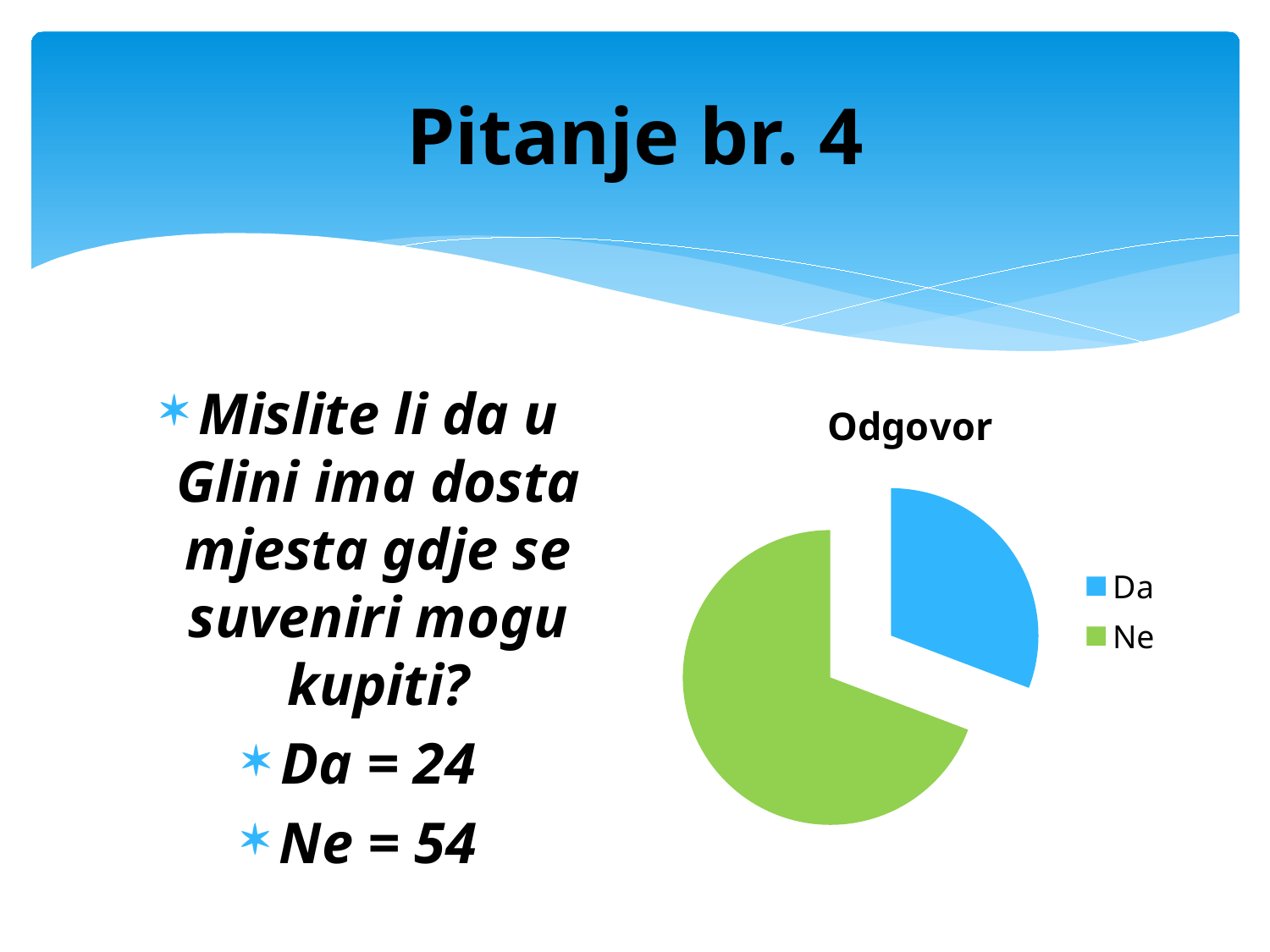
How many entries does the chart legend list? 2 What is the total of the Da and Ne values given on the slide? 78 Which is larger in the pie chart, Da or Ne? Ne What value does the slide give for Ne? 54 What value does the slide give for Da? 24 What is the difference between the Ne and Da values given on the slide? 30 How many slices does the pie chart have? 2 Which colour represents Ne in the pie chart? green What is the title of the chart? Odgovor Which slice of the pie chart is the smallest? Da Which slice of the pie chart is the largest? Ne What kind of chart is shown on the slide? pie chart